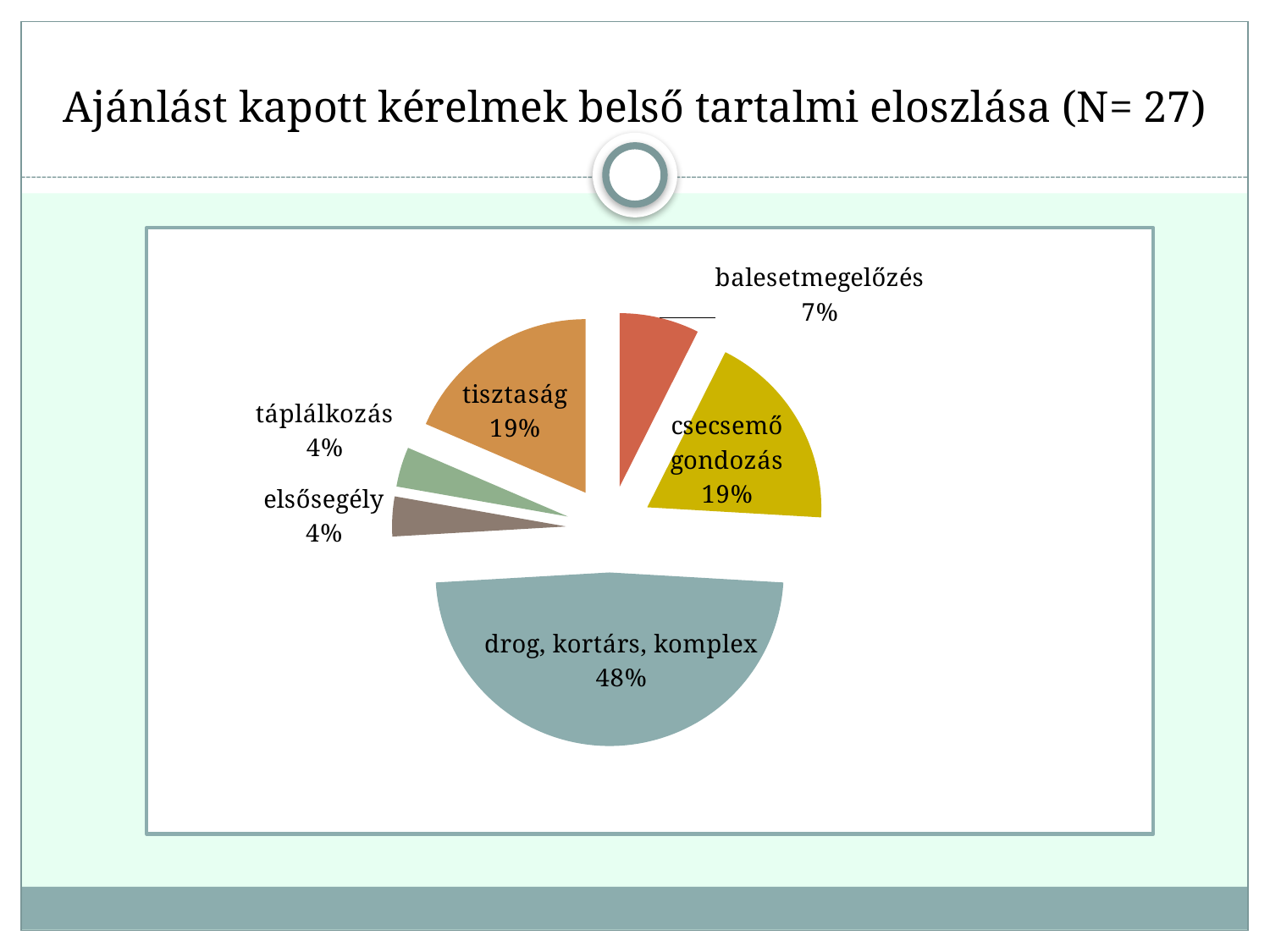
Which is larger, the share for "balesetmegelőzés" or the share for "táplálkozás"? balesetmegelőzés What is the value for "elsősegély"? 4% What kind of chart is shown on the slide? pie chart What is the difference between the shares of "drog, kortárs, komplex" and "tisztaság"? 29% Which category has the largest slice of the pie? drog, kortárs, komplex What is the difference between the shares of "csecsemő gondozás" and "balesetmegelőzés"? 12% How many slices does the pie chart have? 6 What share of the pie does "drog, kortárs, komplex" have? 48% What is the value for "balesetmegelőzés"? 7% What is the value for "tisztaság"? 19% What is the title of the chart slide? Ajánlást kapott kérelmek belső tartalmi eloszlása (N= 27) What colour is the "csecsemő gondozás" slice? yellow